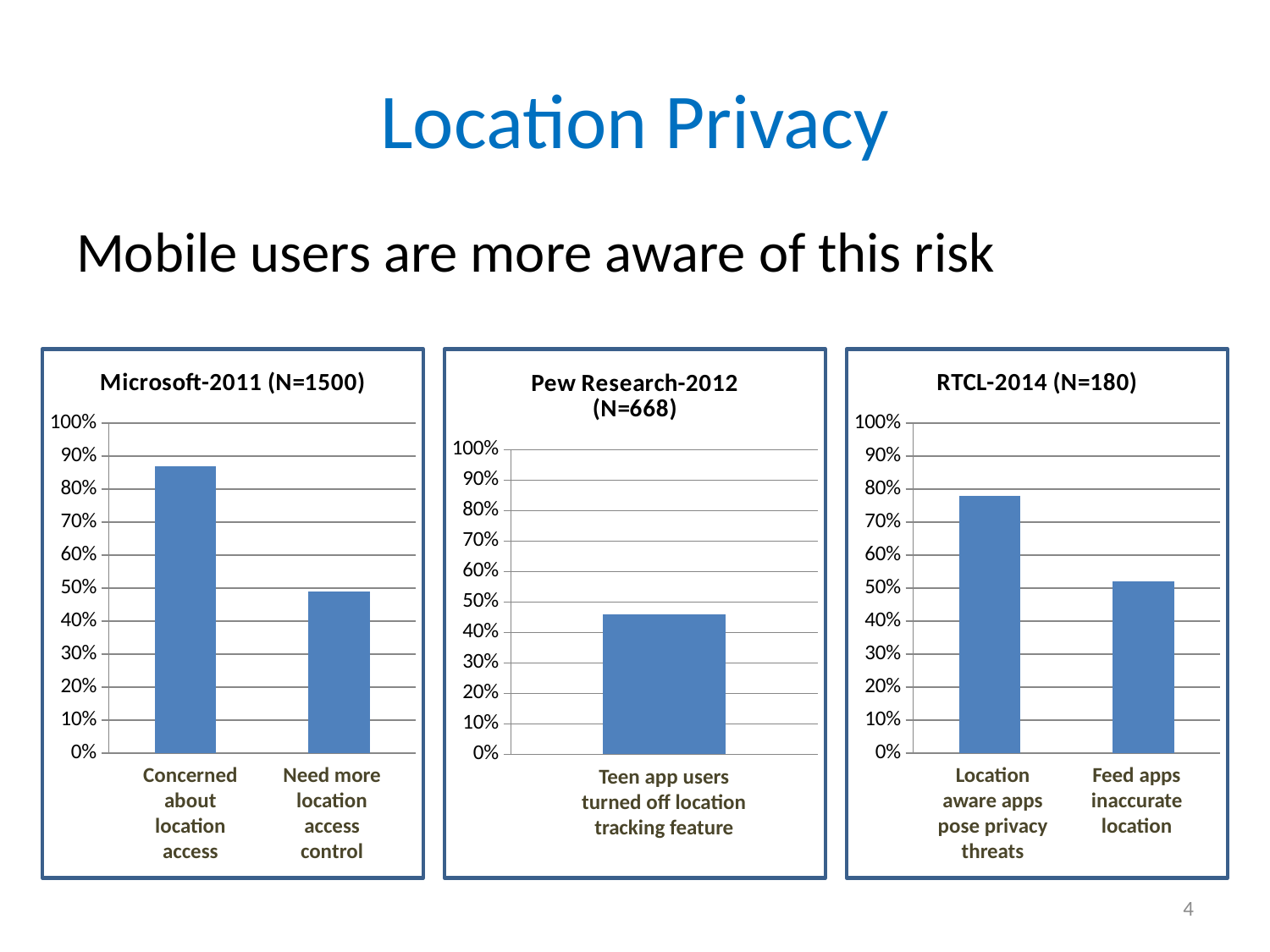
In the RTCL-2014 (N=180) chart, is the value for Location aware apps pose privacy threats greater or less than 70%? greater In the RTCL-2014 (N=180) chart, which category has the highest value? Location aware apps pose privacy threats In the Microsoft-2011 (N=1500) chart, which category has the highest value? Concerned about location access In the Microsoft-2011 (N=1500) chart, which category has the lowest value? Need more location access control In the RTCL-2014 (N=180) chart, is the value for Feed apps inaccurate location greater or less than 60%? less How many bars are plotted in the Pew Research-2012 (N=668) chart? 1 In the Microsoft-2011 (N=1500) chart, is the value for Concerned about location access greater or less than 80%? greater How many categories are shown in the RTCL-2014 (N=180) chart? 2 What type of chart is the Microsoft-2011 (N=1500) chart? Bar chart